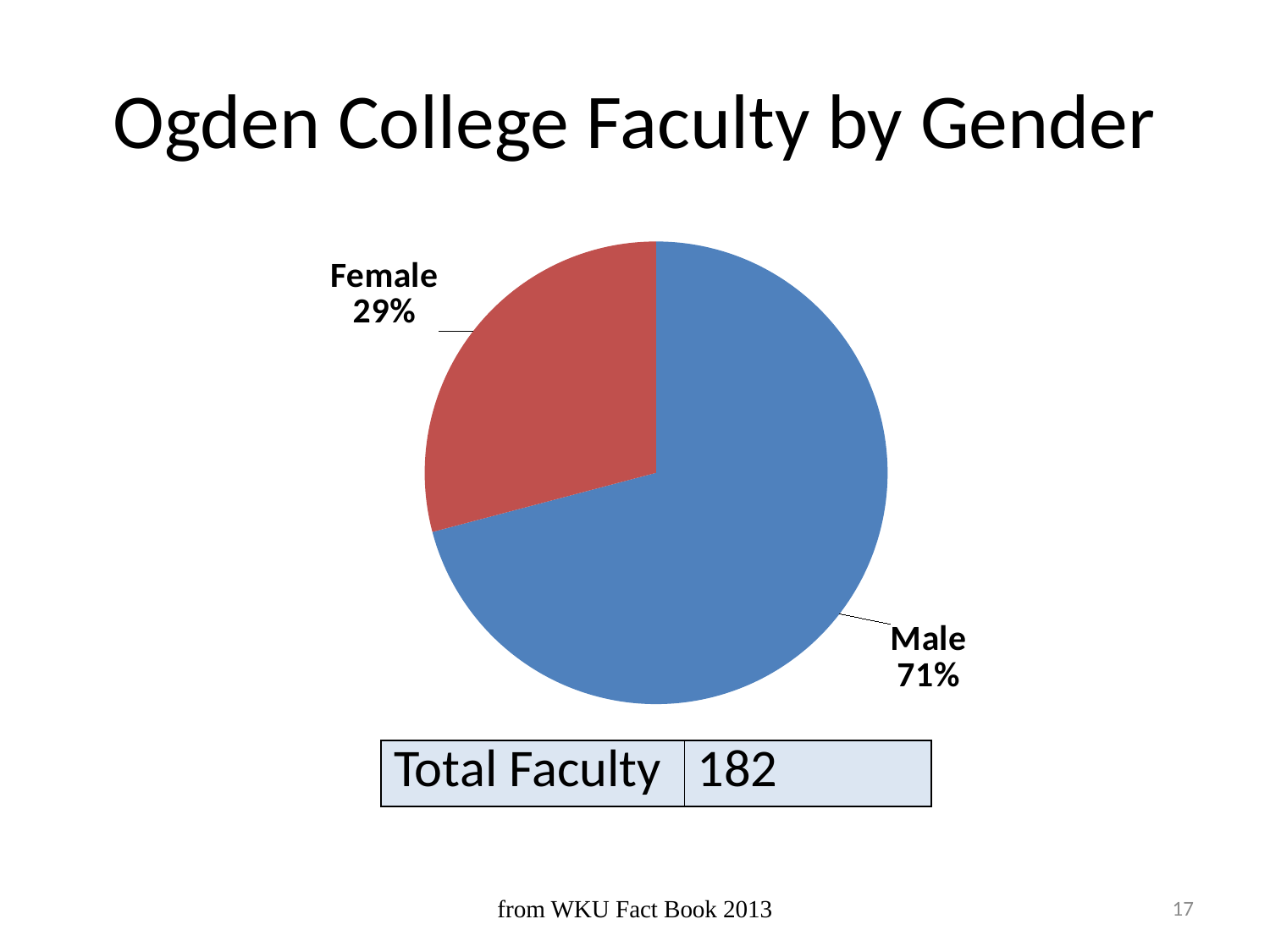
What is the difference in percentage points between the Male and Female shares? 42 What percentage of Ogden College faculty is Female? 29% What colour is the Male slice of the pie? Blue What kind of chart is shown on the slide? Pie chart What share of the pie does the Female slice represent? 29% What percentage of Ogden College faculty is Male? 71% What is the total faculty count shown below the chart? 182 Which gender has the smallest share of the pie? Female How many slices does the pie chart have? 2 What is the title of the chart? Ogden College Faculty by Gender Which share is larger, Male or Female? Male Which gender has the largest share of the pie? Male